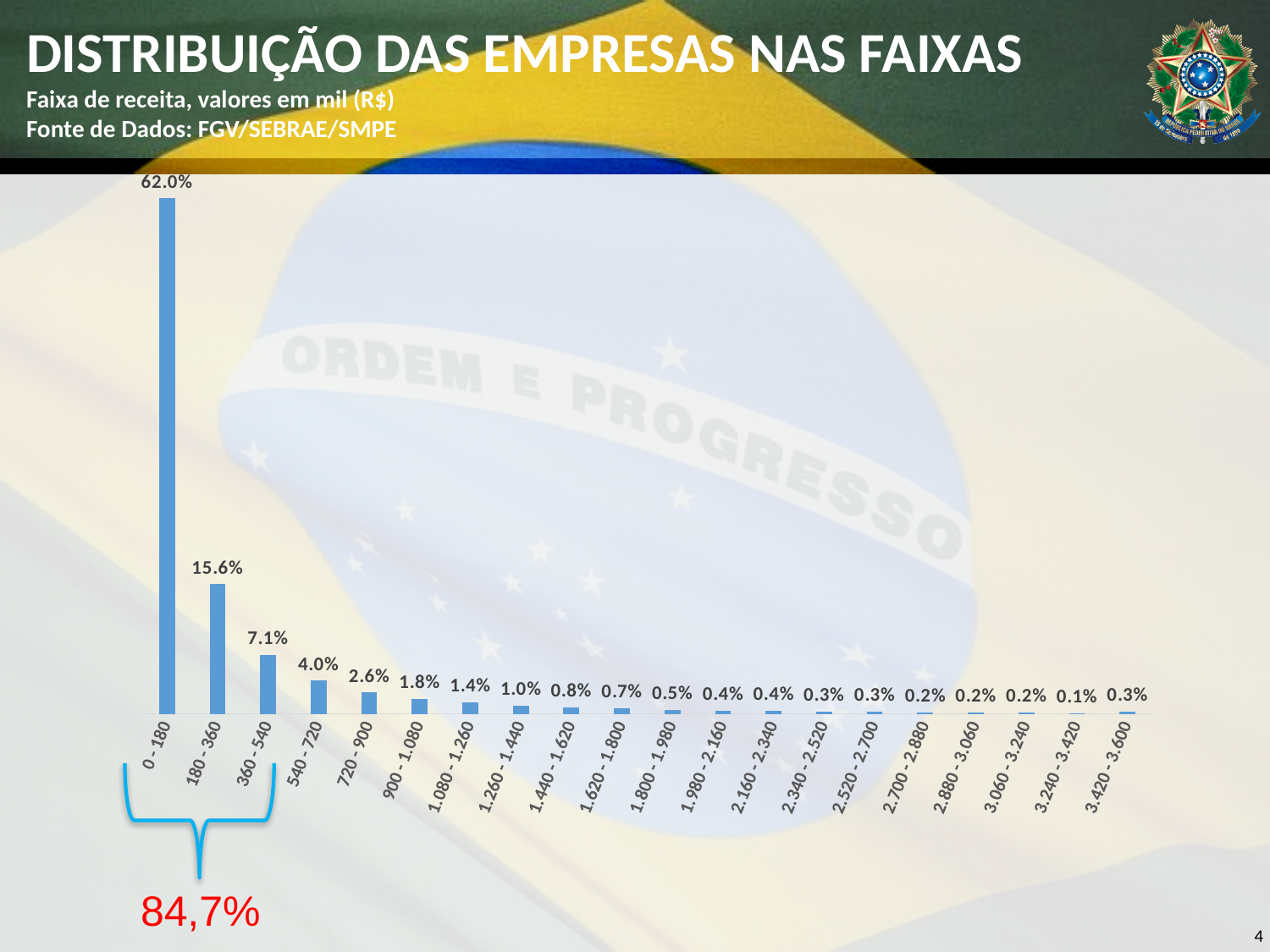
Which revenue band has the lowest share of companies? 3.240 - 3.420 What combined percentage is annotated in red for the first three revenue bands? 84,7% What is the value shown for the 1.260 - 1.440 band? 1.0% What percentage of companies fall in the 0 - 180 revenue band? 62.0% What is the difference in percentage points between the 0 - 180 band and the 180 - 360 band? 46.4 Do the values generally rise or fall as the revenue bands increase along the x axis? Fall What is the value shown for the 180 - 360 band? 15.6% Which revenue band has the highest share of companies? 0 - 180 Which band has a larger share: 360 - 540 or 720 - 900? 360 - 540 How many revenue bands are shown on the x axis? 20 What type of chart is shown on the slide? Bar chart What is the value shown for the 540 - 720 band? 4.0%